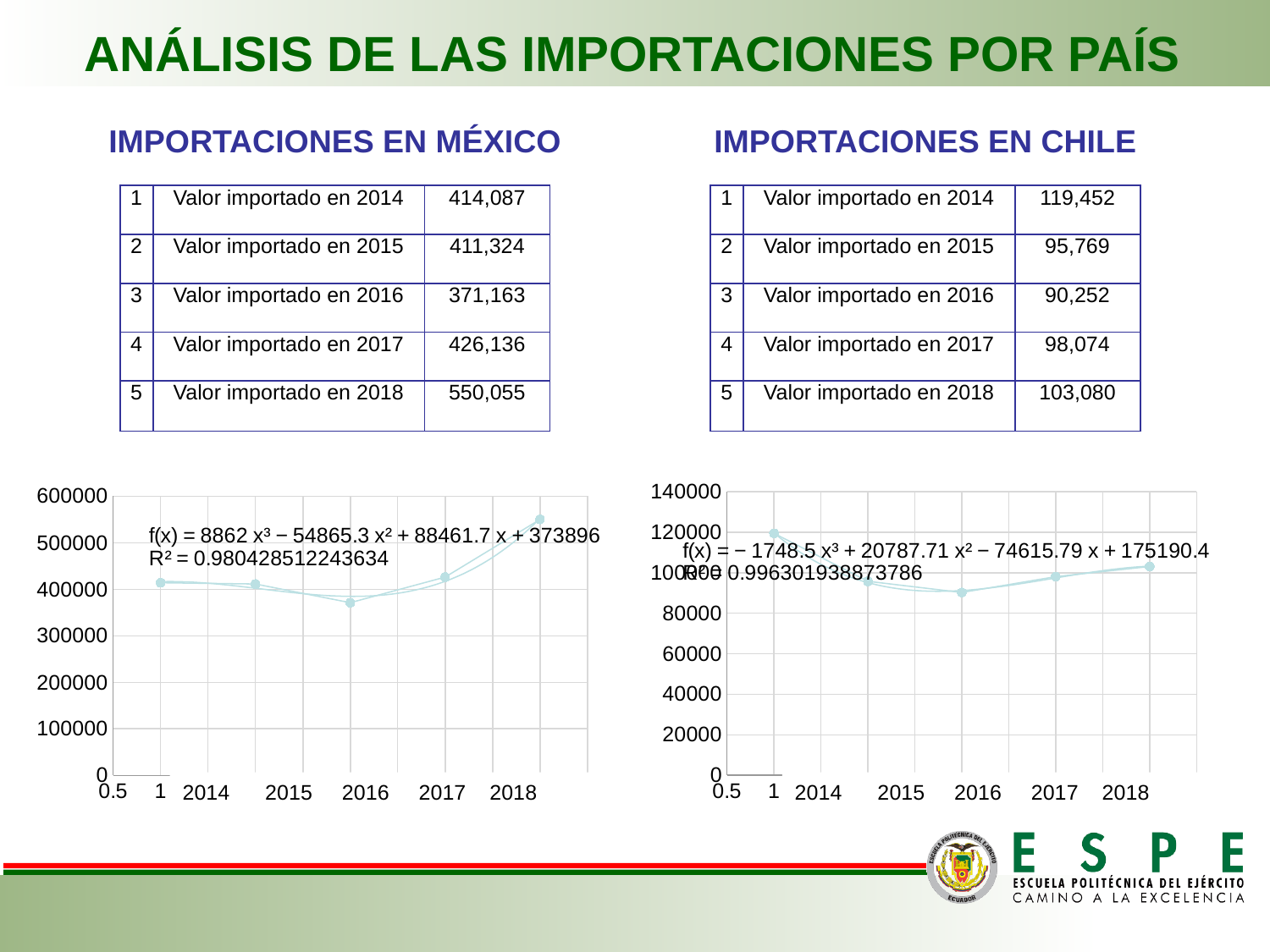
What kind of chart is the Importaciones en México chart? line chart In the Importaciones en México chart, which year has the highest imported value? 2018 For Importaciones en Chile, which is larger: the imported value in 2014 or in 2015? 2014 In the Importaciones en México chart, which year has the lowest imported value? 2016 In the Importaciones en Chile chart, is the value for 2016 greater or less than 100000? less How many data points are plotted in the Importaciones en Chile chart? 5 In the Importaciones en Chile chart, which year has the highest imported value? 2014 What R² value is shown on the Importaciones en México chart? 0.980428512243634 In the Importaciones en Chile chart, do the values rise or fall from 2016 to 2018? rise For Importaciones en México, what is the difference between the 2018 and 2017 imported values? 123,919 What is the imported value for 2018 shown for Importaciones en México? 550,055 In the Importaciones en México chart, is the value for 2018 greater or less than 500000? greater